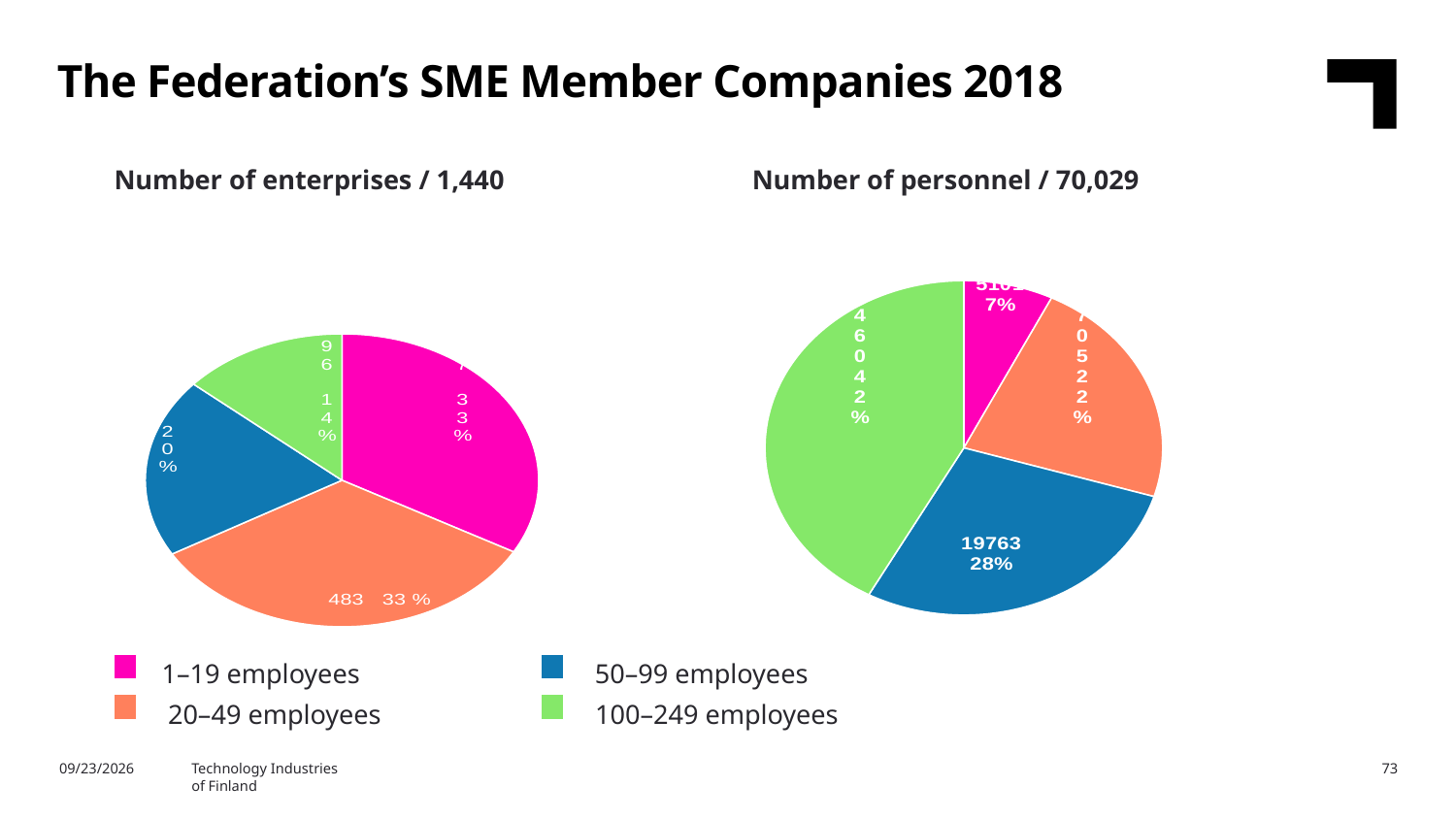
In the 'Number of personnel / 70,029' chart, what is the value for 50–99 employees? 19763 What kind of chart is used for 'Number of enterprises / 1,440'? Pie chart In the 'Number of personnel / 70,029' chart, which category has the largest slice? 100–249 employees What total number of personnel is stated in the title of the right-hand chart? 70,029 In the 'Number of personnel / 70,029' chart, which is larger: the slice for 50–99 employees or the slice for 20–49 employees? 50–99 employees In the 'Number of enterprises / 1,440' chart, what share of the pie is 100–249 employees? 14% In the 'Number of personnel / 70,029' chart, what share of the pie is 1–19 employees? 7% In the 'Number of enterprises / 1,440' chart, which category has the smallest slice? 100–249 employees In the 'Number of enterprises / 1,440' chart, what is the value for 20–49 employees? 483 In the 'Number of enterprises / 1,440' chart, what share of the pie is 50–99 employees? 20% How many categories does the legend list for the pie charts? 4